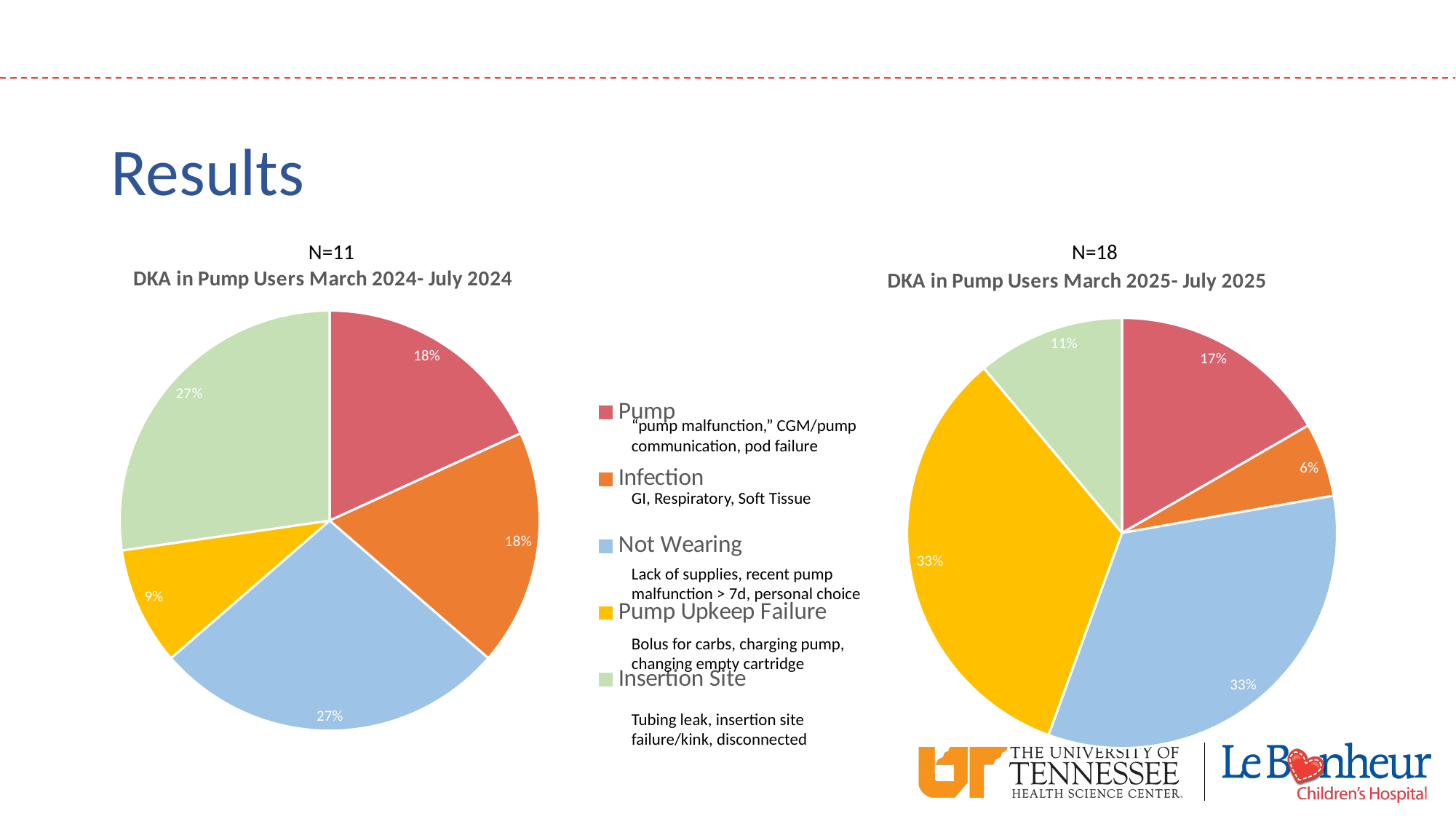
What kind of chart is used for 'DKA in Pump Users March 2025- July 2025'? Pie chart How many categories does the legend list for the pie charts? 5 In the 'DKA in Pump Users March 2024- July 2024' chart, which category has the smallest slice? Pump Upkeep Failure In the 'DKA in Pump Users March 2024- July 2024' chart, what share of the pie is Not Wearing? 27% Which colour represents Pump Upkeep Failure in the legend? Yellow In the 'DKA in Pump Users March 2024- July 2024' chart, which is larger, Insertion Site or Pump? Insertion Site In the 'DKA in Pump Users March 2025- July 2025' chart, what percentage is shown for Infection? 6% In the 'DKA in Pump Users March 2025- July 2025' chart, which category has the smallest slice? Infection What is the N value shown above the 'DKA in Pump Users March 2025- July 2025' chart? N=18 In the 'DKA in Pump Users March 2025- July 2025' chart, what is the difference between the Not Wearing and Pump percentages? 16% In the 'DKA in Pump Users March 2025- July 2025' chart, what share of the pie is Insertion Site? 11% In the 'DKA in Pump Users March 2024- July 2024' chart, what percentage is shown for Pump Upkeep Failure? 9%